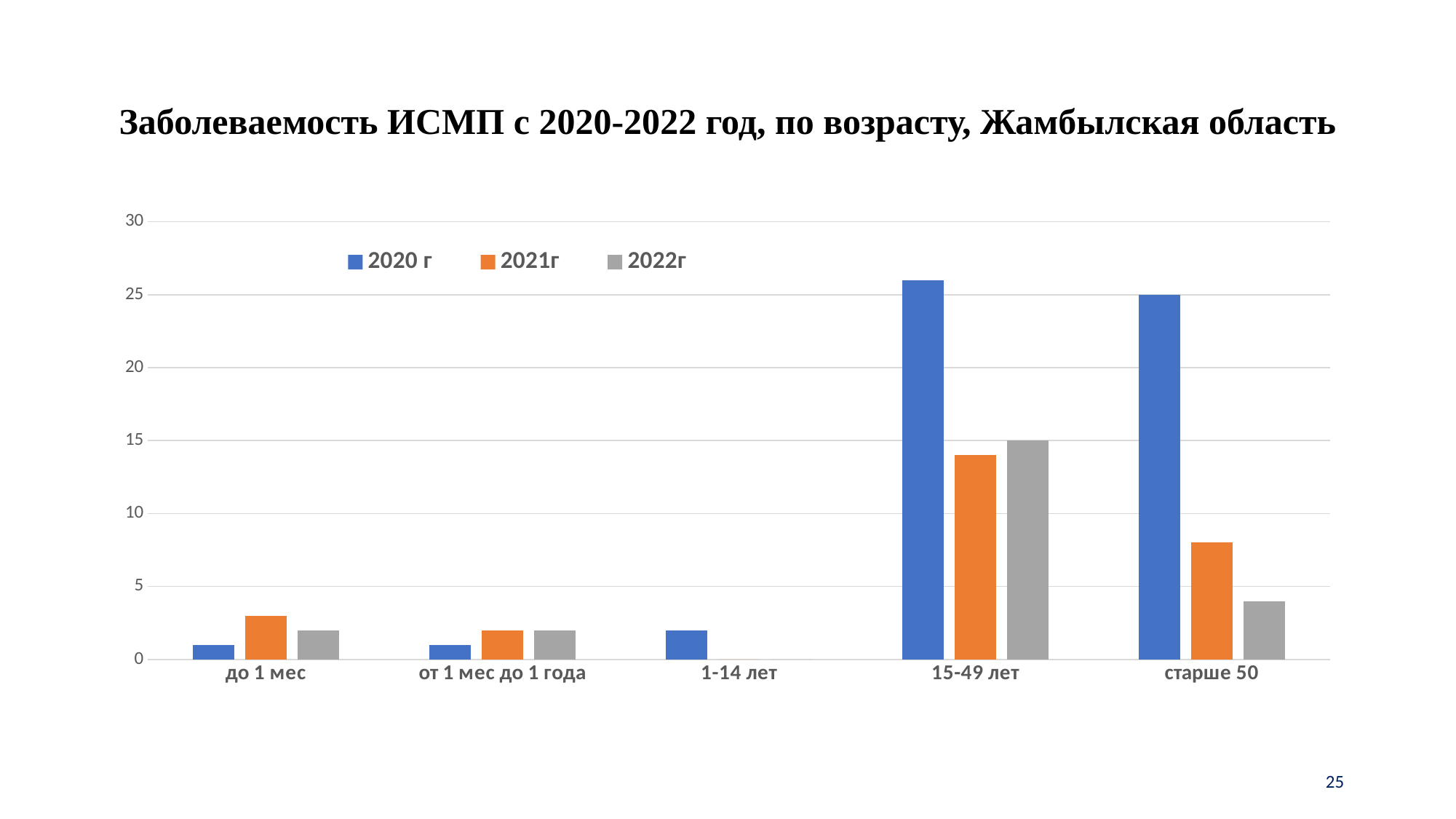
How many series does the legend list? 3 How many age categories are shown on the x axis? 5 Is the value for 15-49 лет in the 2020 г series greater or less than 25? greater What is the value for 15-49 лет in the 2022г series? 15 Is the value for старше 50 in the 2022г series greater or less than 5? less Is the value for старше 50 in the 2021г series greater or less than 10? less For старше 50, which series has the larger value: 2021г or 2022г? 2021г What kind of chart is shown on the slide? bar chart Which age category has the highest value in the 2022г series? 15-49 лет Which series is shown in orange in the legend? 2021г What is the value for старше 50 in the 2020 г series? 25 Which age category has the highest value in the 2021г series? 15-49 лет